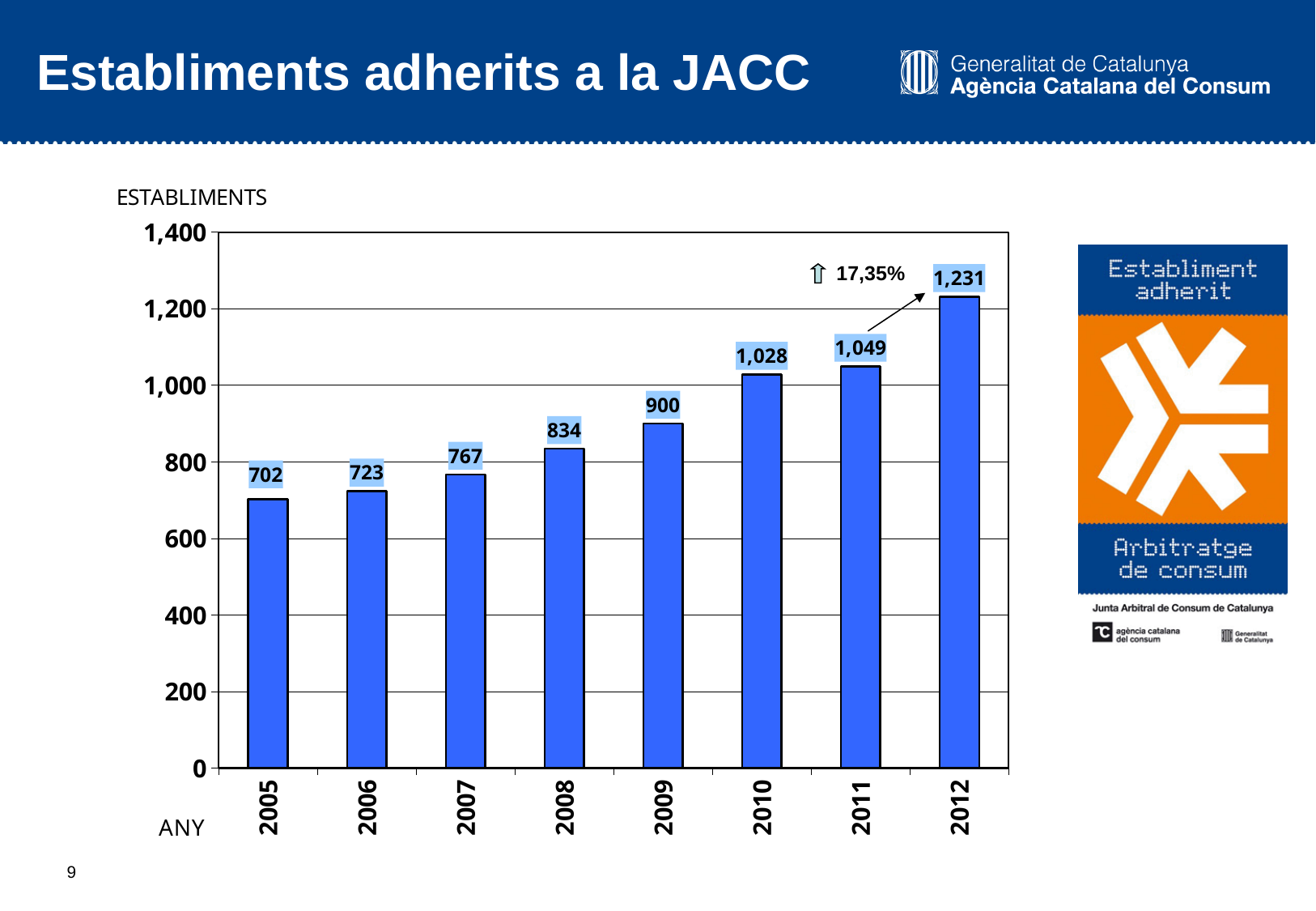
What is the number of establishments for 2012? 1,231 What is the number of establishments for 2009? 900 How many years are shown on the x axis? 8 What is the number of establishments for 2005? 702 Do the values rise or fall from 2005 to 2012? rise Which year has the lowest number of establishments? 2005 Which year has the highest number of establishments? 2012 Which is larger, the value for 2010 or the value for 2009? 2010 What kind of chart is shown on the slide? bar chart What is the difference between the values for 2008 and 2007? 67 Is the value for 2006 greater or less than 800? less What is the difference between the values for 2012 and 2011? 182